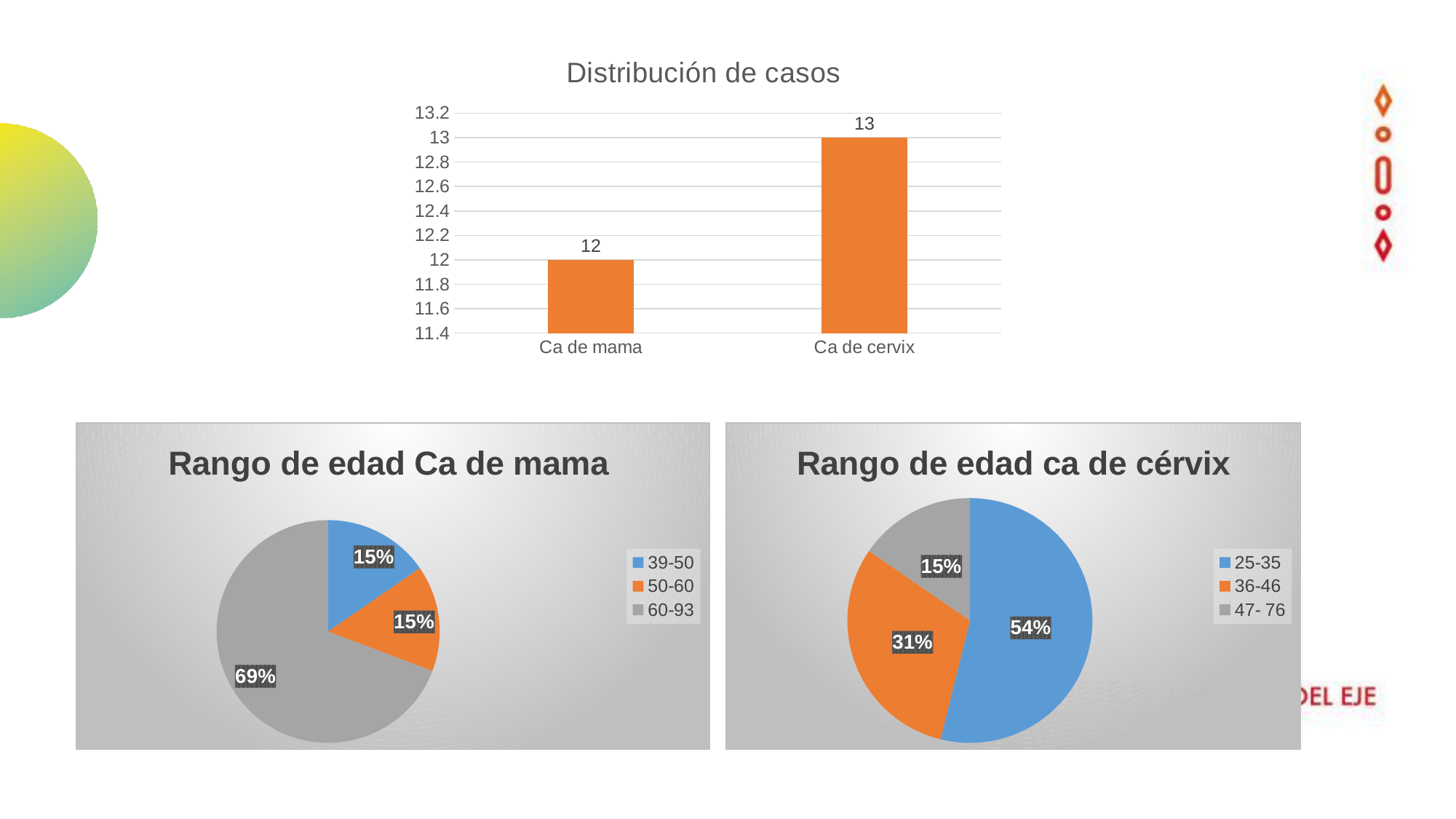
How many categories are shown in the 'Distribución de casos' chart? 2 In the 'Rango de edad Ca de mama' pie chart, what share does the 39-50 slice have? 15% In the 'Rango de edad Ca de mama' pie chart, what share does the 60-93 slice have? 69% In the 'Distribución de casos' chart, what is the value for Ca de mama? 12 In the 'Rango de edad ca de cérvix' pie chart, which age range has the smallest share? 47- 76 How many entries does the legend of the 'Rango de edad ca de cérvix' pie chart list? 3 In the 'Distribución de casos' chart, which category has the highest value? Ca de cervix What kind of chart is 'Distribución de casos'? Bar chart In the 'Distribución de casos' chart, what is the difference between Ca de cervix and Ca de mama? 1 In the 'Rango de edad ca de cérvix' pie chart, what share does the 36-46 slice have? 31% In the 'Distribución de casos' chart, what is the value for Ca de cervix? 13 In the 'Rango de edad ca de cérvix' pie chart, which age range has the largest share? 25-35